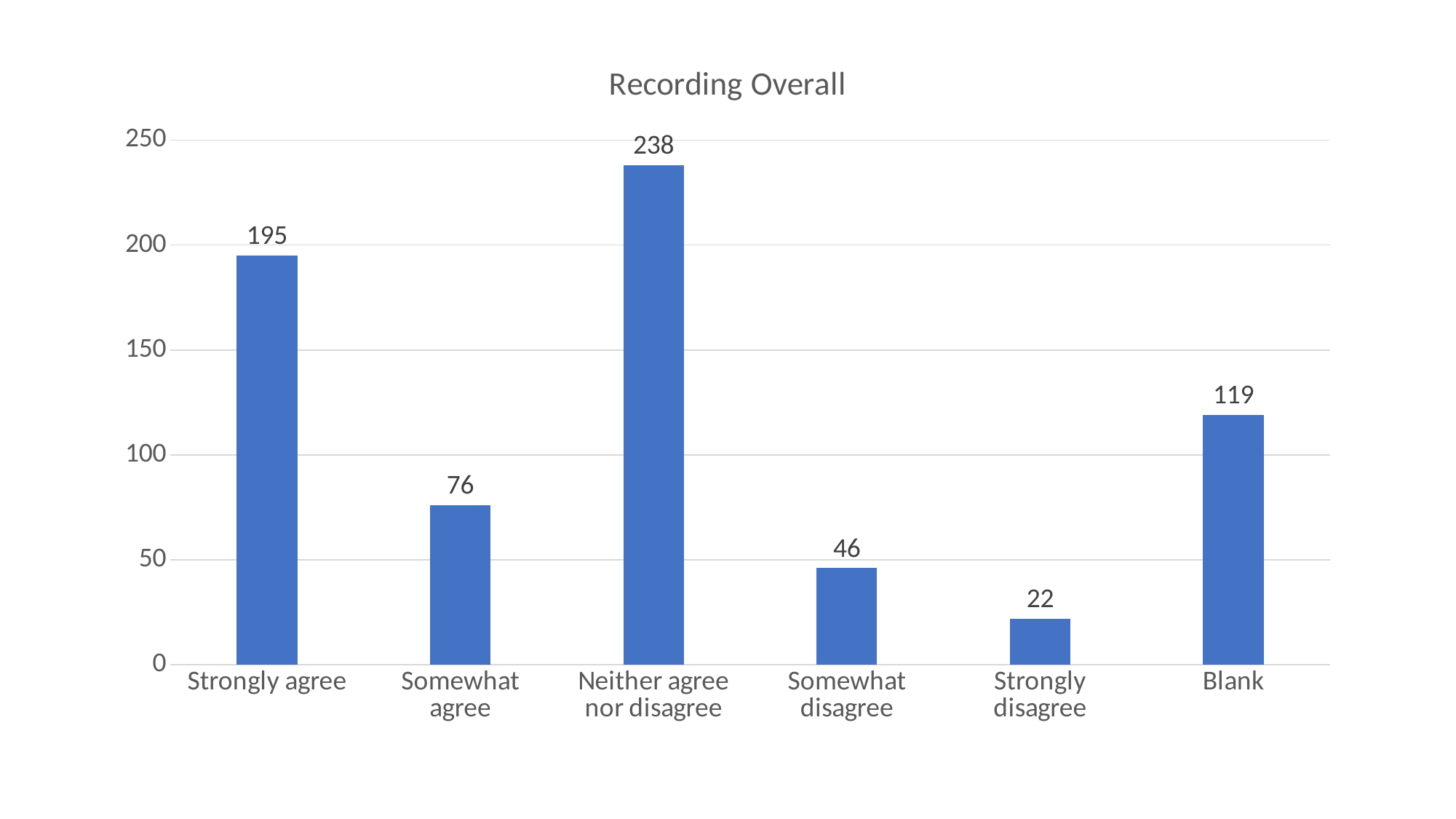
What is the value for Neither agree nor disagree? 238 Which category has the highest value? Neither agree nor disagree Is the value for Somewhat disagree greater or less than 50? less Which is larger, the value for Somewhat agree or the value for Blank? Blank What is the value for Strongly disagree? 22 Which category has the lowest value? Strongly disagree What is the value for Blank? 119 What is the difference between the values for Somewhat agree and Somewhat disagree? 30 What is the difference between the values for Neither agree nor disagree and Strongly agree? 43 What is the value for Strongly agree? 195 What is the title of the chart? Recording Overall How many categories are shown on the x axis? 6